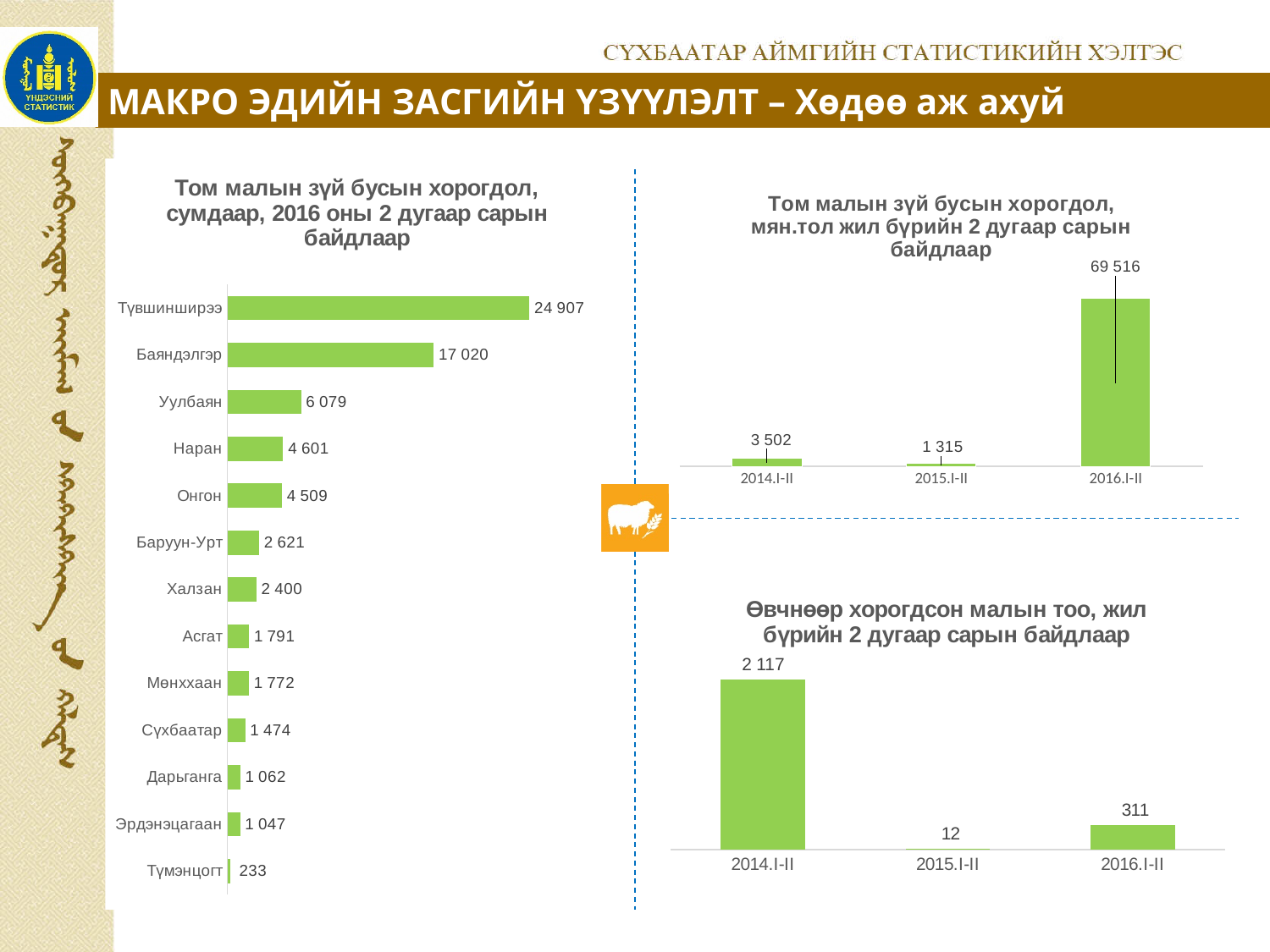
In the left chart (Том малын зүй бусын хорогдол, сумдаар), how many soums are shown? 13 In the left chart (Том малын зүй бусын хорогдол, сумдаар), what is the value for Түвшинширээ? 24 907 In the top right chart (Том малын зүй бусын хорогдол, мян.тол), what is the value for 2016.I-II? 69 516 In the bottom right chart (Өвчнөөр хорогдсон малын тоо), what is the difference between 2014.I-II and 2016.I-II? 1 806 In the left chart (Том малын зүй бусын хорогдол, сумдаар), which is larger, Наран or Онгон? Наран In the top right chart (Том малын зүй бусын хорогдол, мян.тол), which period has the lowest value? 2015.I-II In the left chart (Том малын зүй бусын хорогдол, сумдаар), which soum has the highest value? Түвшинширээ In the bottom right chart (Өвчнөөр хорогдсон малын тоо), what is the value for 2015.I-II? 12 In the left chart (Том малын зүй бусын хорогдол, сумдаар), what is the difference between Түвшинширээ and Баяндэлгэр? 7 887 In the left chart (Том малын зүй бусын хорогдол, сумдаар), what is the value for Сүхбаатар? 1 474 In the left chart (Том малын зүй бусын хорогдол, сумдаар), which soum has the lowest value? Түмэнцогт What type of chart is the left chart (Том малын зүй бусын хорогдол, сумдаар)? Bar chart